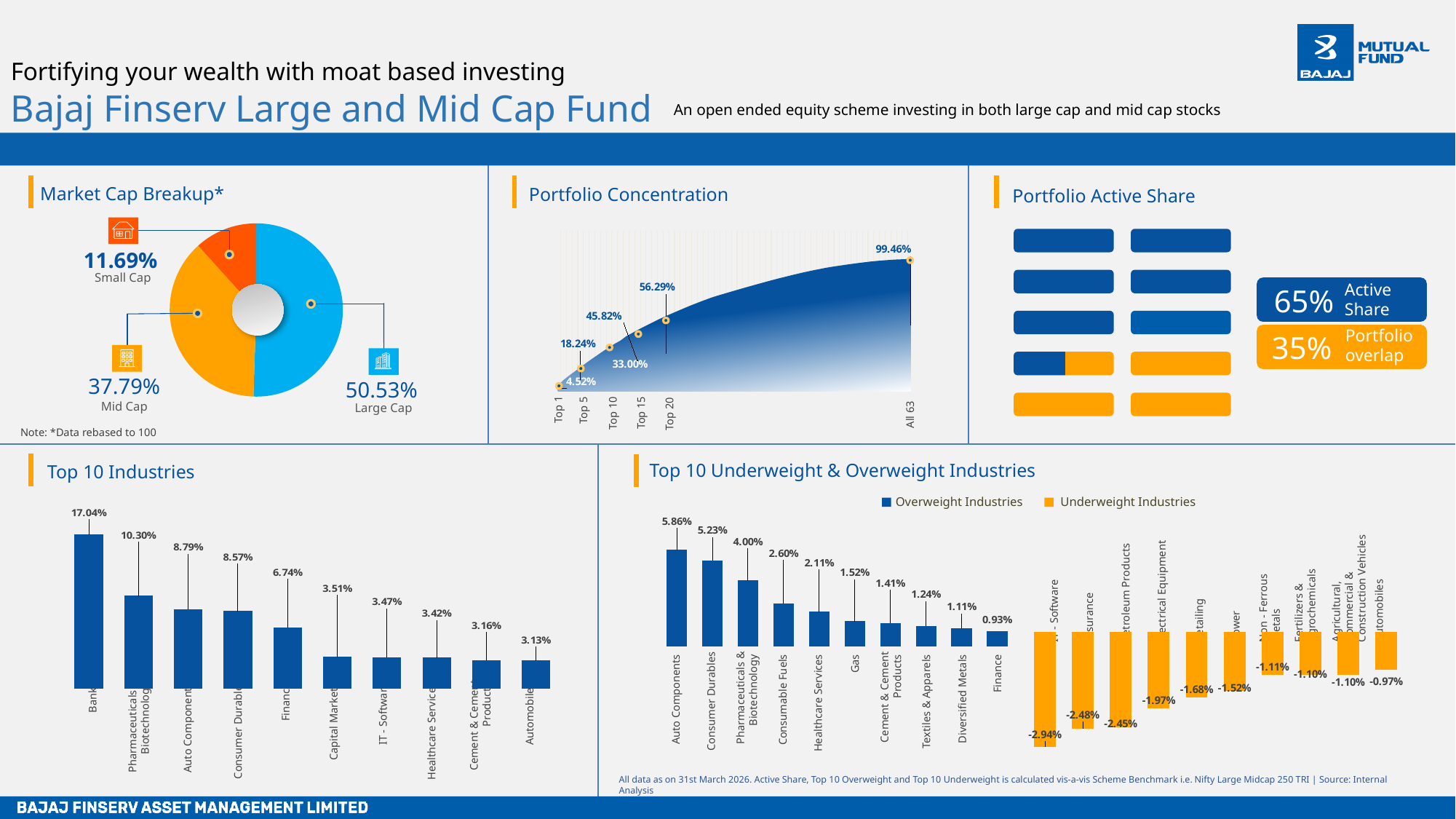
What kind of chart is the Market Cap Breakup chart? Pie (donut) chart In the Top 10 Underweight & Overweight Industries chart, what is the value for Consumable Fuels? 2.60% In the Top 10 Industries chart, what is the value for Banks? 17.04% In the Portfolio Concentration chart, do the values rise or fall from Top 1 to All 63? Rise In the Market Cap Breakup chart, which segment is the smallest? Small Cap In the Portfolio Concentration chart, what is the value for Top 10? 33.00% In the Top 10 Industries chart, which industry has the lowest value? Automobiles In the Market Cap Breakup chart, what share is Large Cap? 50.53% How many series does the legend of the Top 10 Underweight & Overweight Industries chart list? 2 In the Top 10 Underweight & Overweight Industries chart, which is larger: the overweight value for Auto Components or for Consumer Durables? Auto Components In the Portfolio Concentration chart, what is the difference between the Top 20 value and the Top 5 value? 38.05% In the Top 10 Industries chart, how many industries are plotted? 10